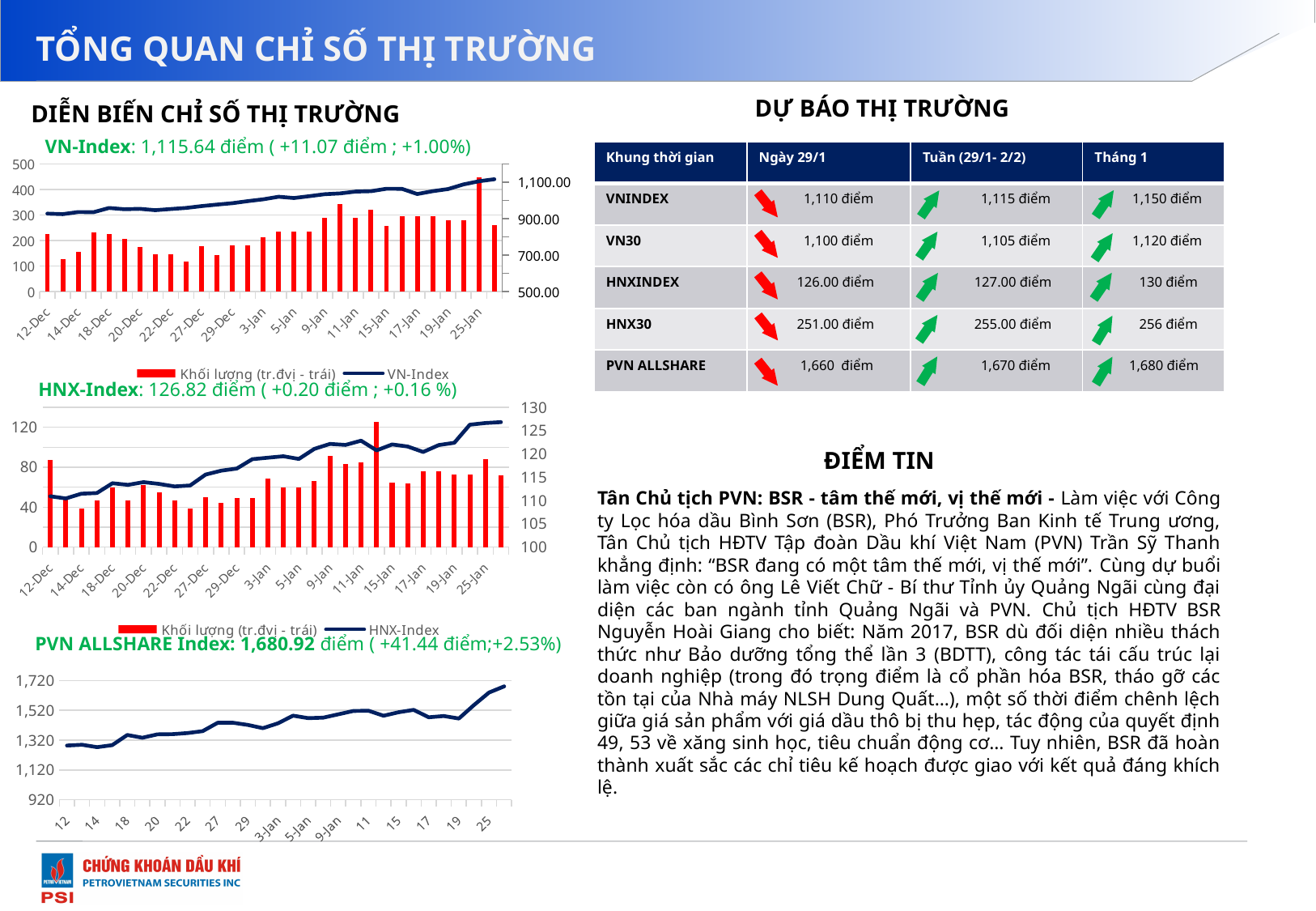
In the PVN ALLSHARE Index chart, does the line generally rise or fall along the x axis? rise What kind of chart is the PVN ALLSHARE Index chart? line chart In the PVN ALLSHARE Index chart, is the value at 12 greater or less than 1,520? less In the VN-Index chart, is the VN-Index line value at 12-Dec greater or less than 1,100.00? less What kind of chart is the VN-Index chart? bar and line chart In the VN-Index chart, does the VN-Index line generally rise or fall from 12-Dec to 25-Jan? rise How many series does the legend of the VN-Index chart list? 2 In the PVN ALLSHARE Index chart, is the value at 25 greater or less than 1,520? greater According to the title of the VN-Index chart, what is the VN-Index value? 1,115.64 điểm In the HNX-Index chart, does the HNX-Index line generally rise or fall from 12-Dec to 25-Jan? rise How many series does the legend of the HNX-Index chart list? 2